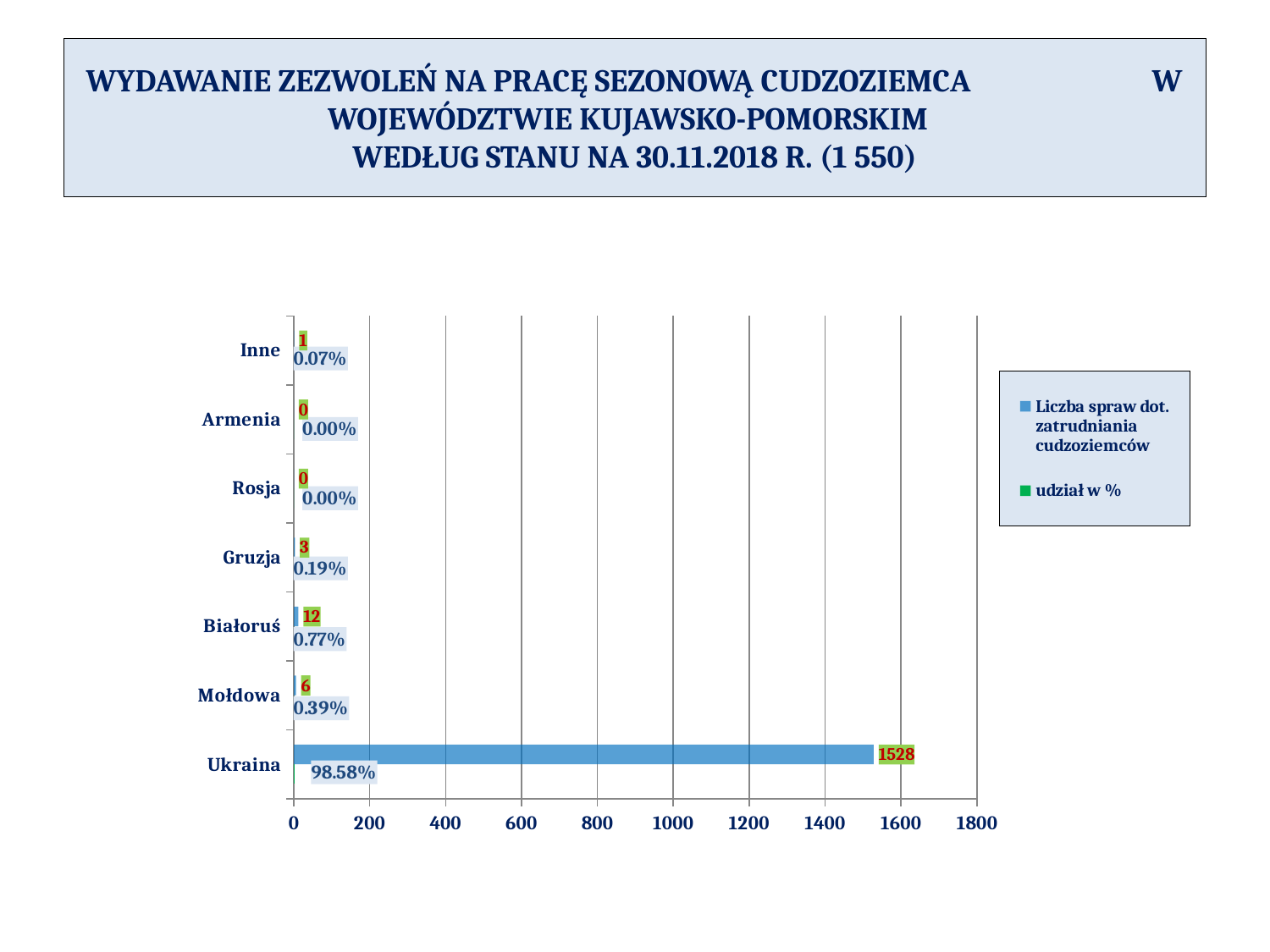
What is the difference in the number of cases between Białoruś and Mołdowa? 6 Which has more cases, Gruzja or Mołdowa? Mołdowa What is the number of cases for Białoruś? 12 What is the number of cases (Liczba spraw) for Ukraina? 1528 What kind of chart is shown on the slide? bar chart Which category has the highest number of cases? Ukraina How many series does the legend list? 2 What is the number of cases for Gruzja? 3 What is the percentage share for Mołdowa? 0.39% What is the percentage share (udział w %) for Ukraina? 98.58% Is the number of cases for Ukraina greater or less than 1400? greater How many categories are shown on the y axis? 7